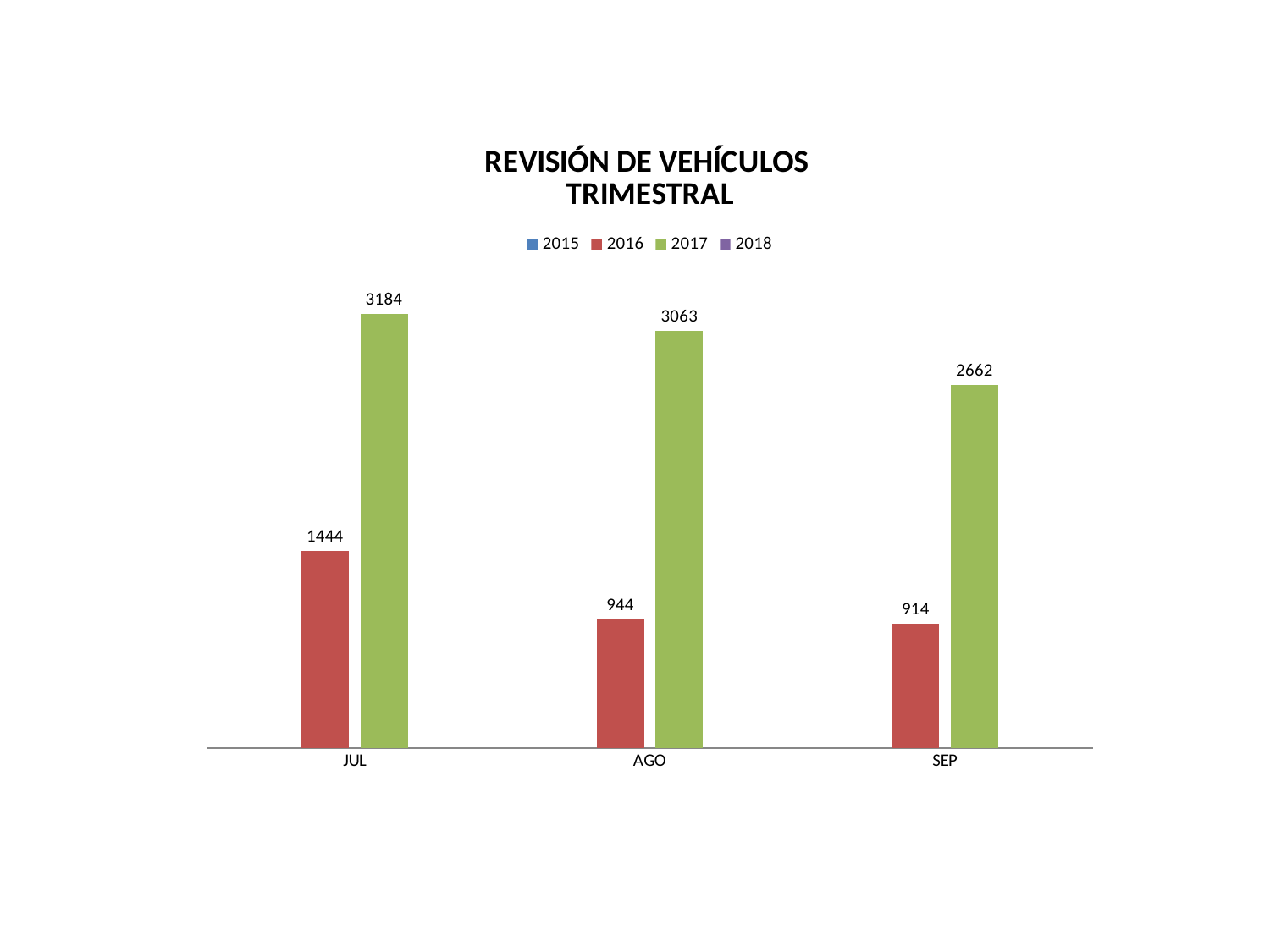
What is the value for 2017 in JUL? 3184 What is the value for 2016 in AGO? 944 What is the value for 2017 in SEP? 2662 Which is larger: the 2016 value in JUL or the 2016 value in AGO? JUL How many months are shown on the x axis? 3 What kind of chart is this? Bar chart What is the value for 2016 in SEP? 914 What is the difference between the 2017 and 2016 values in JUL? 1740 In which month is the 2017 value highest? JUL In which month is the 2016 value lowest? SEP What is the difference between the 2017 values in AGO and SEP? 401 How many series does the legend list? 4